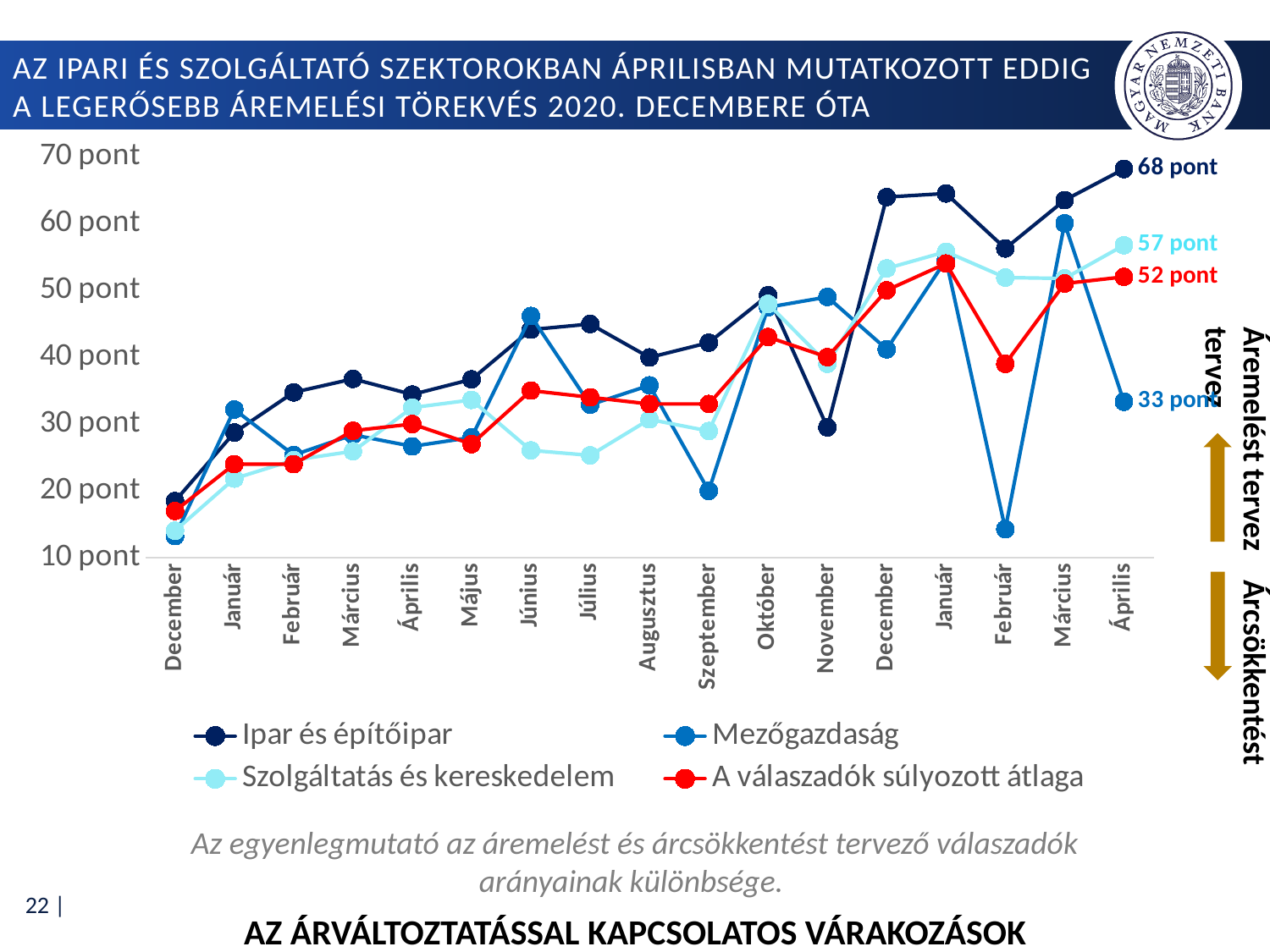
At the final Április point, what is the difference between the Ipar és építőipar value and the Mezőgazdaság value? 35 pont What is the value of A válaszadók súlyozott átlaga at the final Április point? 52 pont Which series has the highest value at the final Április point? Ipar és építőipar Which series has the lowest value at the final Április point? Mezőgazdaság What kind of chart is shown on the slide? Line chart Does the Ipar és építőipar series generally rise or fall from the first December to the final Április? rise What is the value of the Szolgáltatás és kereskedelem series at the final Április point? 57 pont What is the value of the Mezőgazdaság series at the final Április point? 33 pont Is the value of the Mezőgazdaság series at the second Február greater or less than 20 pont? less At the final Április point, what is the difference between the Szolgáltatás és kereskedelem value and A válaszadók súlyozott átlaga? 5 pont How many series does the legend list? 4 What is the value of the Ipar és építőipar series at the final Április point? 68 pont